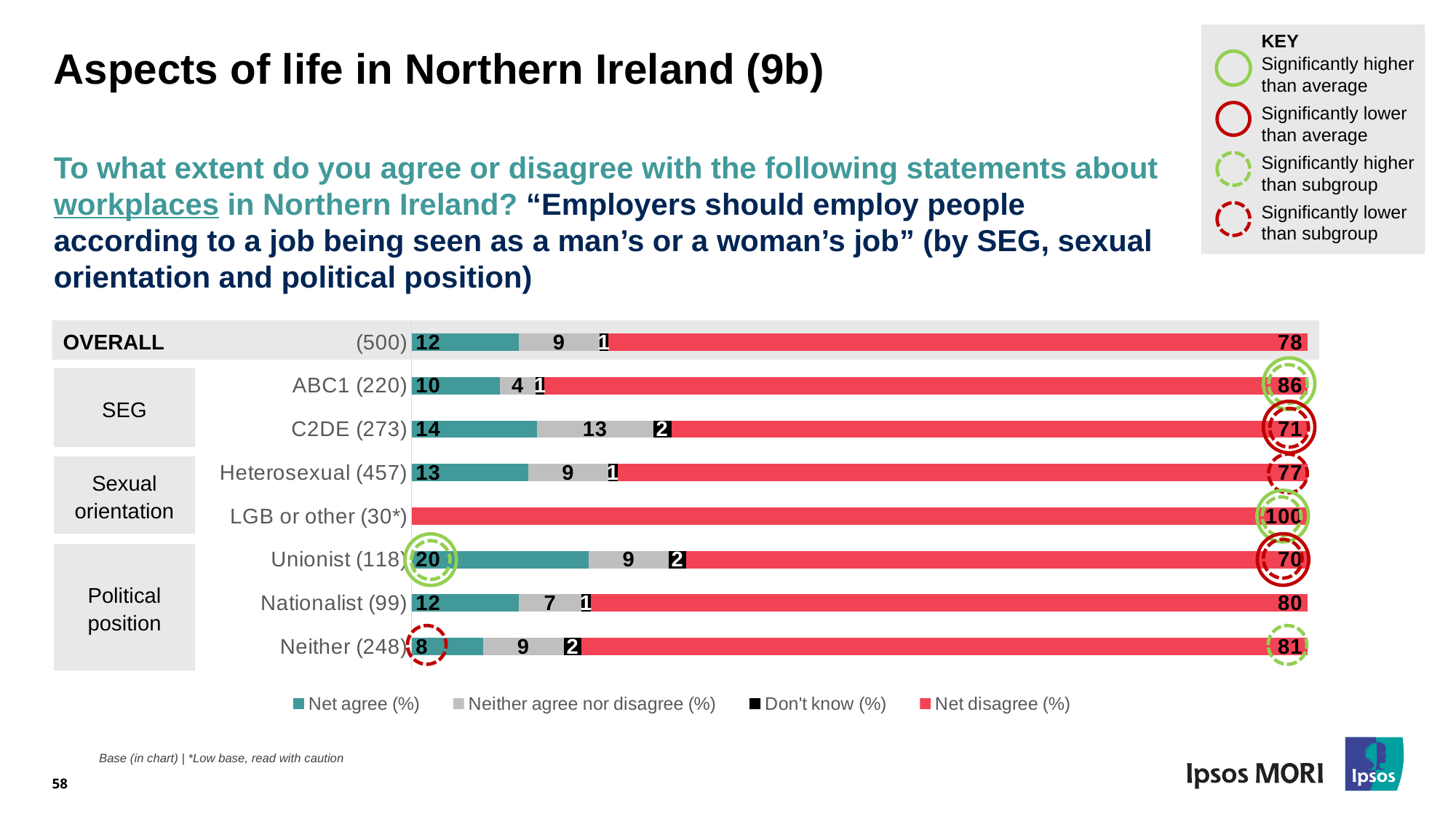
What is the Net disagree (%) value for LGB or other respondents? 100 How many series does the legend list? 4 How many groups (bars) are shown in the chart? 8 What kind of chart is shown on the slide? Stacked bar chart What is the Don't know (%) value for Heterosexual respondents? 1 Which is larger, the Net agree (%) value for Nationalist or for Neither? Nationalist Which group has the highest Net agree (%) value? Unionist What is the Net disagree (%) value for the OVERALL group? 78 What is the Neither agree nor disagree (%) value for C2DE respondents? 13 What is the Net agree (%) value for Unionist respondents? 20 What is the difference between the Net disagree (%) values for ABC1 and C2DE? 15 Which group has the lowest Net disagree (%) value? Unionist